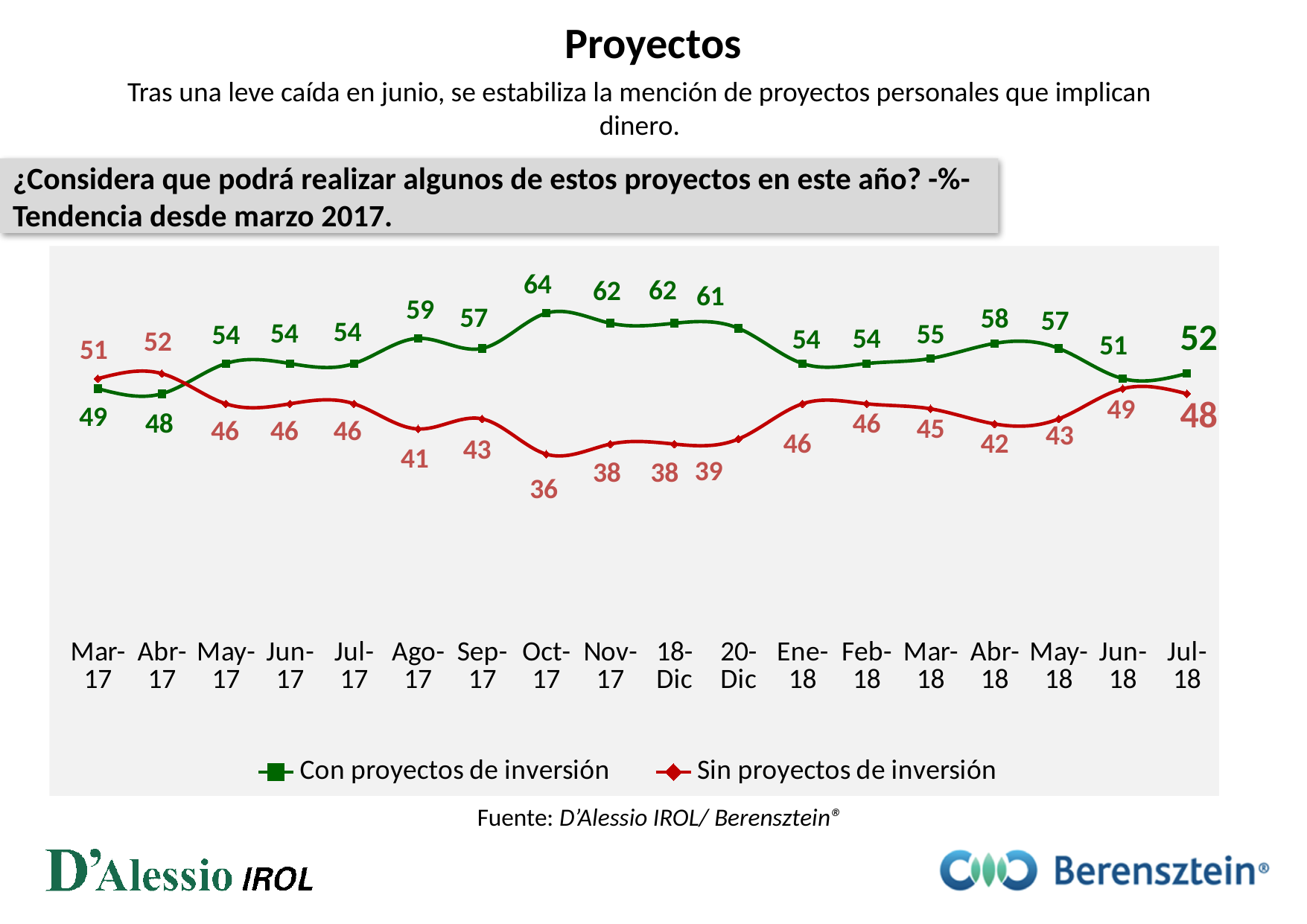
Does 'Con proyectos de inversión' rise or fall from Abr-18 to Jun-18? Fall What is the value for 'Con proyectos de inversión' in Oct-17? 64 How many series does the legend list? 2 What kind of chart is shown on the slide? Line chart How many time periods are plotted on the x axis? 18 What is the difference between 'Con proyectos de inversión' and 'Sin proyectos de inversión' in Oct-17? 28 What is the value for 'Sin proyectos de inversión' in Jul-18? 48 In which period does 'Sin proyectos de inversión' reach its lowest value? Oct-17 Which series has the higher value in Abr-17, 'Con proyectos de inversión' or 'Sin proyectos de inversión'? Sin proyectos de inversión In which period does 'Con proyectos de inversión' have its lowest value? Abr-17 What is the value for 'Sin proyectos de inversión' in Ago-17? 41 In which period does 'Con proyectos de inversión' reach its highest value? Oct-17